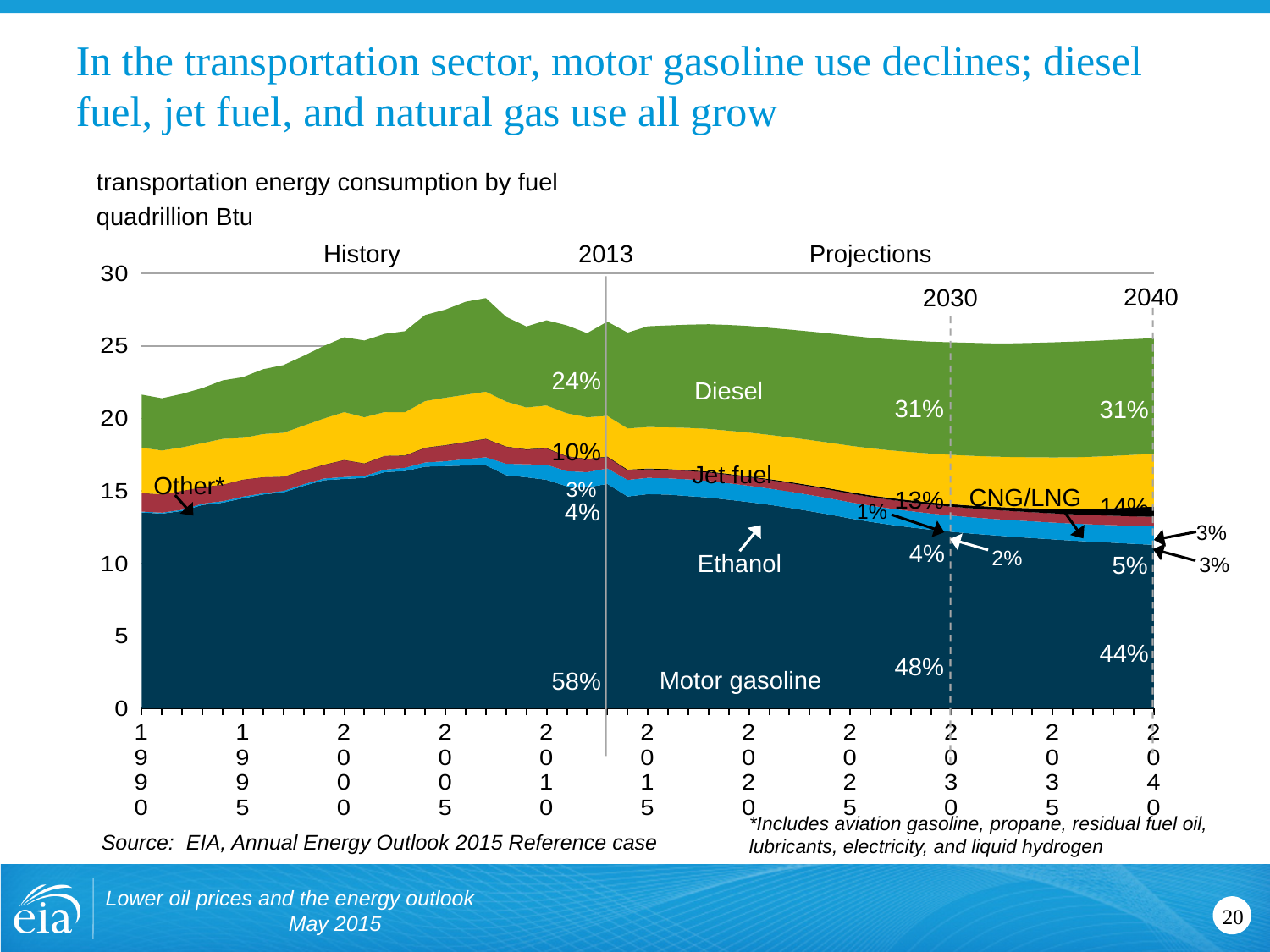
What share does ethanol account for in 2040? 5% What type of chart is shown on the slide? Stacked area chart What share does CNG/LNG account for in 2040? 3% What share of transportation energy consumption does motor gasoline account for in 2013? 58% What share does diesel account for in 2040? 31% Which is larger in 2030, the diesel share or the jet fuel share? Diesel share Which fuel has the largest share of transportation energy consumption in 2040? Motor gasoline What unit is used on the y axis of the chart? quadrillion Btu By how many percentage points does the motor gasoline share fall between 2013 and 2040? 14 percentage points What share does jet fuel account for in 2030? 13% Does the motor gasoline share rise or fall from 2013 to 2040? Fall Is total transportation energy consumption in 2013 greater or less than 25 quadrillion Btu? greater